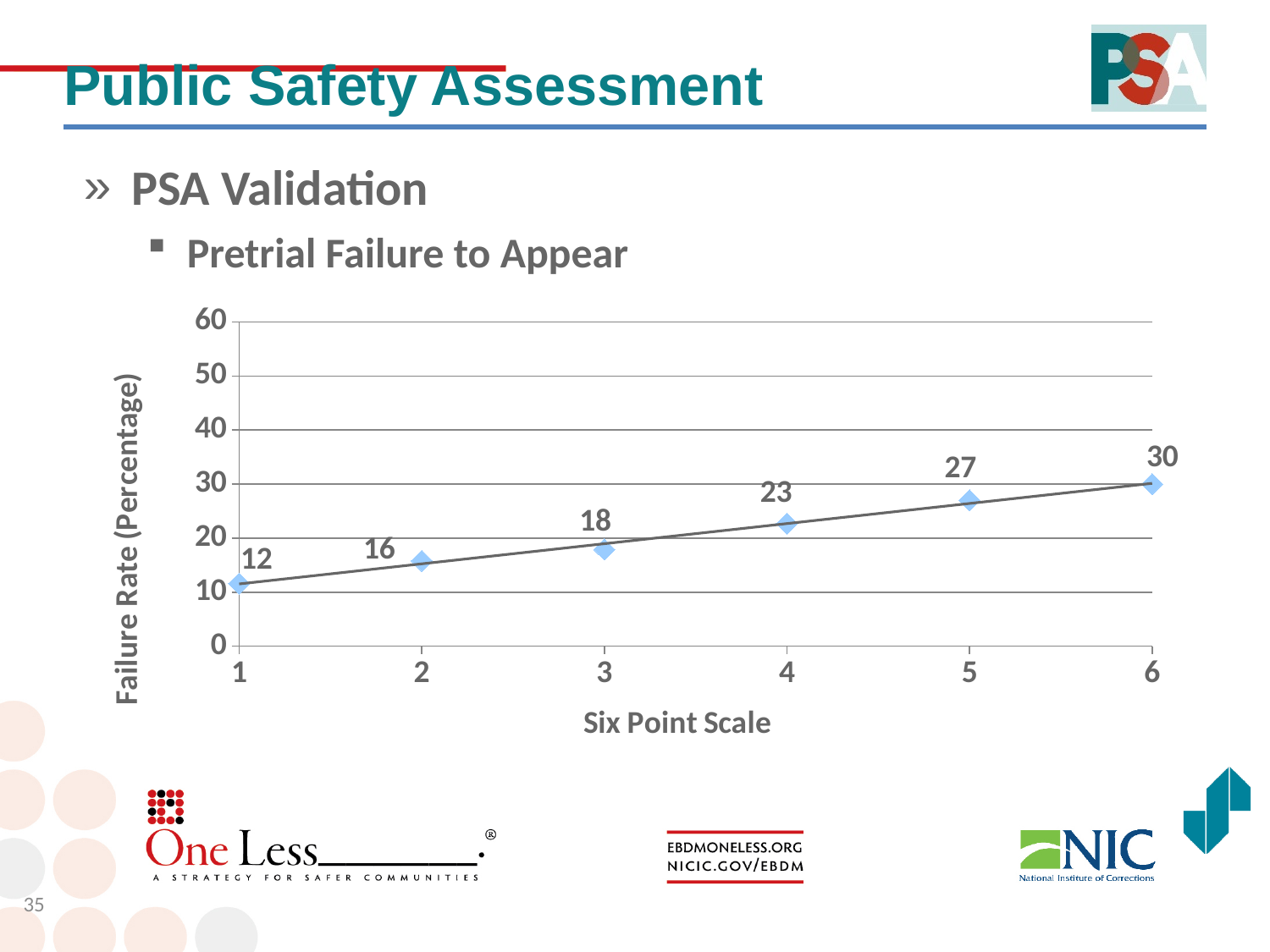
Which point on the six point scale has the highest failure rate? 6 What is the label of the vertical axis? Failure Rate (Percentage) What is the failure rate for scale point 4? 23 Which has a higher failure rate, scale point 2 or scale point 5? 5 Does the failure rate rise or fall as the six point scale increases? rises How many points are plotted on the chart? 6 Which point on the six point scale has the lowest failure rate? 1 What is the difference in failure rate between scale point 6 and scale point 1? 18 What is the failure rate for scale point 1? 12 What is the difference in failure rate between scale point 5 and scale point 3? 9 What is the failure rate for scale point 6? 30 Is the failure rate for scale point 3 greater or less than 20? less